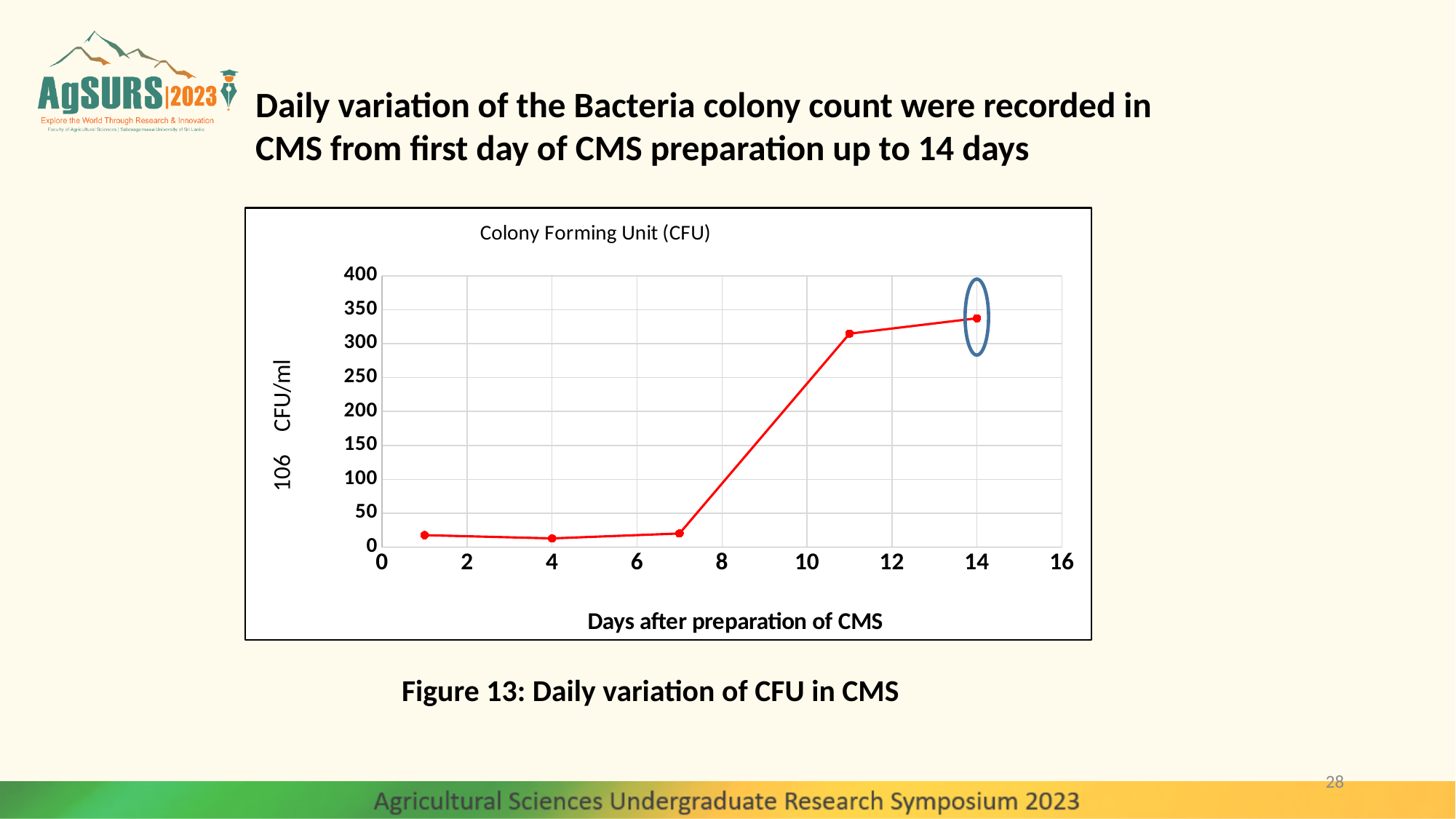
Which has the larger CFU value, day 11 or day 14? Day 14 Is the CFU value at day 7 greater or less than 50? less How many data points are plotted on the line? 5 At which day after preparation is the CFU value highest? 14 Which has the larger CFU value, day 7 or day 11? Day 11 Is the CFU value at day 1 greater or less than 50? less What is the title of the chart? Colony Forming Unit (CFU) What is the label of the x axis of the chart? Days after preparation of CMS Is the CFU value at day 14 greater or less than 350? less Does the CFU value rise or fall between day 7 and day 14? Rise What kind of chart is shown on the slide? Line chart